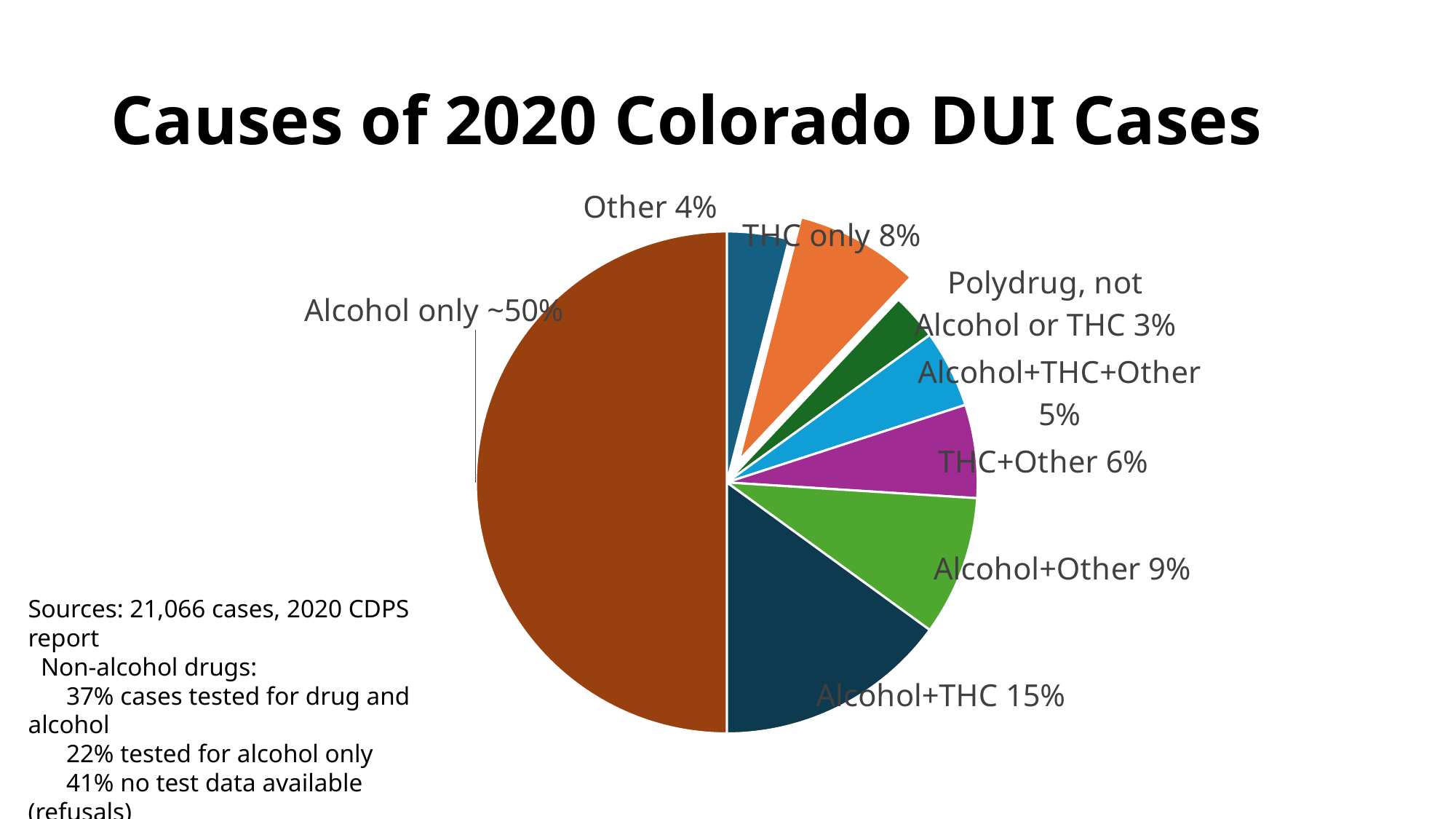
How many slices does the pie chart have? 8 Which category has the smallest slice of the pie? Polydrug, not Alcohol or THC What is the title of the chart? Causes of 2020 Colorado DUI Cases What share of cases is labelled Alcohol+THC? 15% What share of cases is labelled THC+Other? 6% What share of cases is labelled Alcohol+Other? 9% What type of chart is shown on the slide? pie chart Which is larger, the share for Alcohol+THC or the share for THC only? Alcohol+THC What share of cases is labelled THC only? 8% Which category has the largest slice of the pie? Alcohol only What share of cases is labelled Polydrug, not Alcohol or THC? 3% What is the difference in percentage points between Alcohol+THC and Alcohol+Other? 6